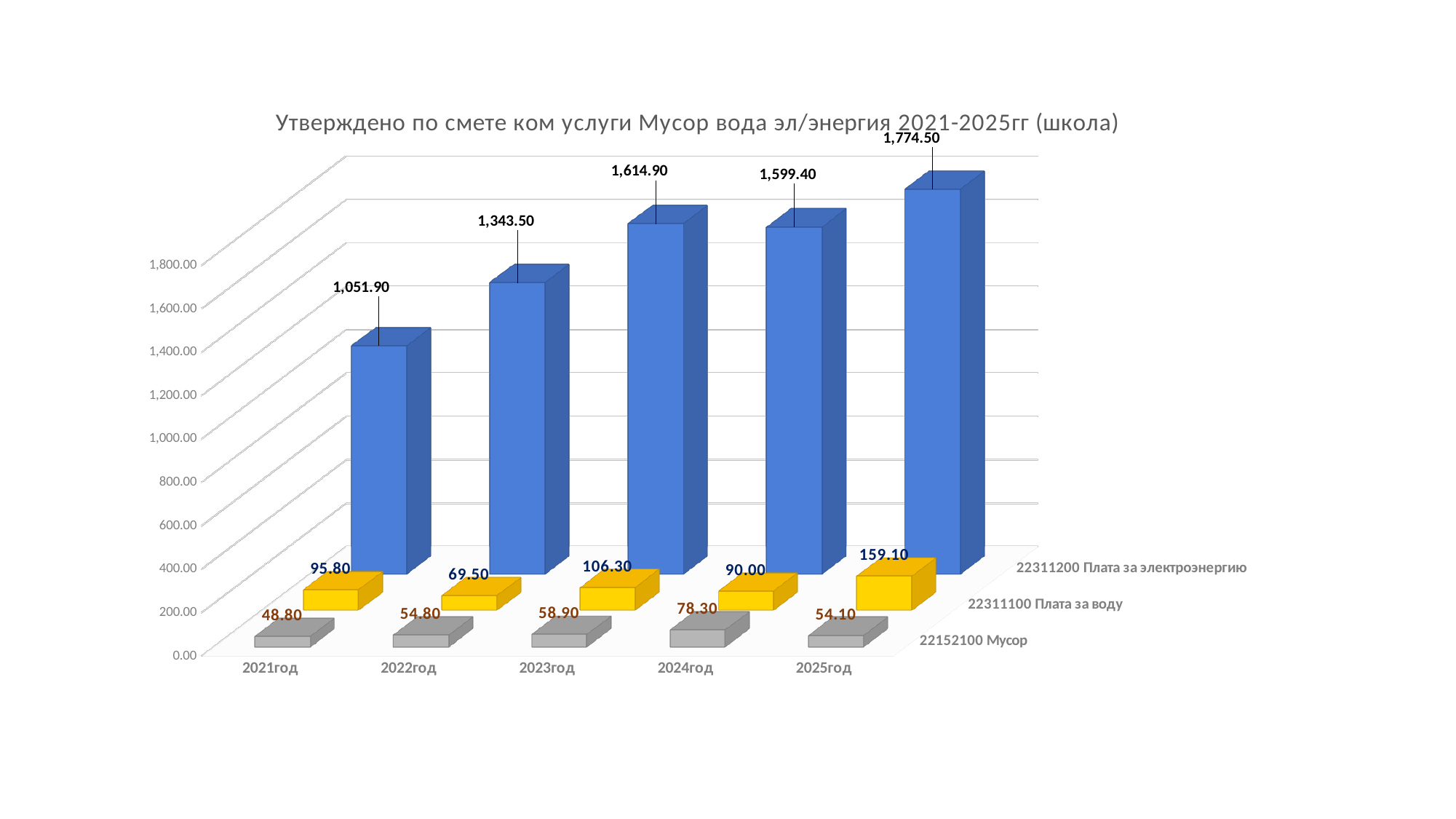
What is the value for 22311100 Плата за воду in 2023год? 106.30 How many years are shown on the x axis? 5 Which is larger: the 22152100 Мусор value for 2021год or for 2025год? 2025год In which year is the value for 22311200 Плата за электроэнергию highest? 2025год What is the value for 22311200 Плата за электроэнергию in 2025год? 1,774.50 What is the title of the chart? Утверждено по смете ком услуги Мусор вода эл/энергия 2021-2025гг (школа) What kind of chart is this? Bar chart Does the value for 22311200 Плата за электроэнергию rise or fall from 2021год to 2023год? Rise What is the value for 22152100 Мусор in 2024год? 78.30 How many data series does the chart show? 3 In which year is the value for 22311100 Плата за воду lowest? 2022год What is the difference between the 22311200 Плата за электроэнергию values for 2023год and 2024год? 15.50